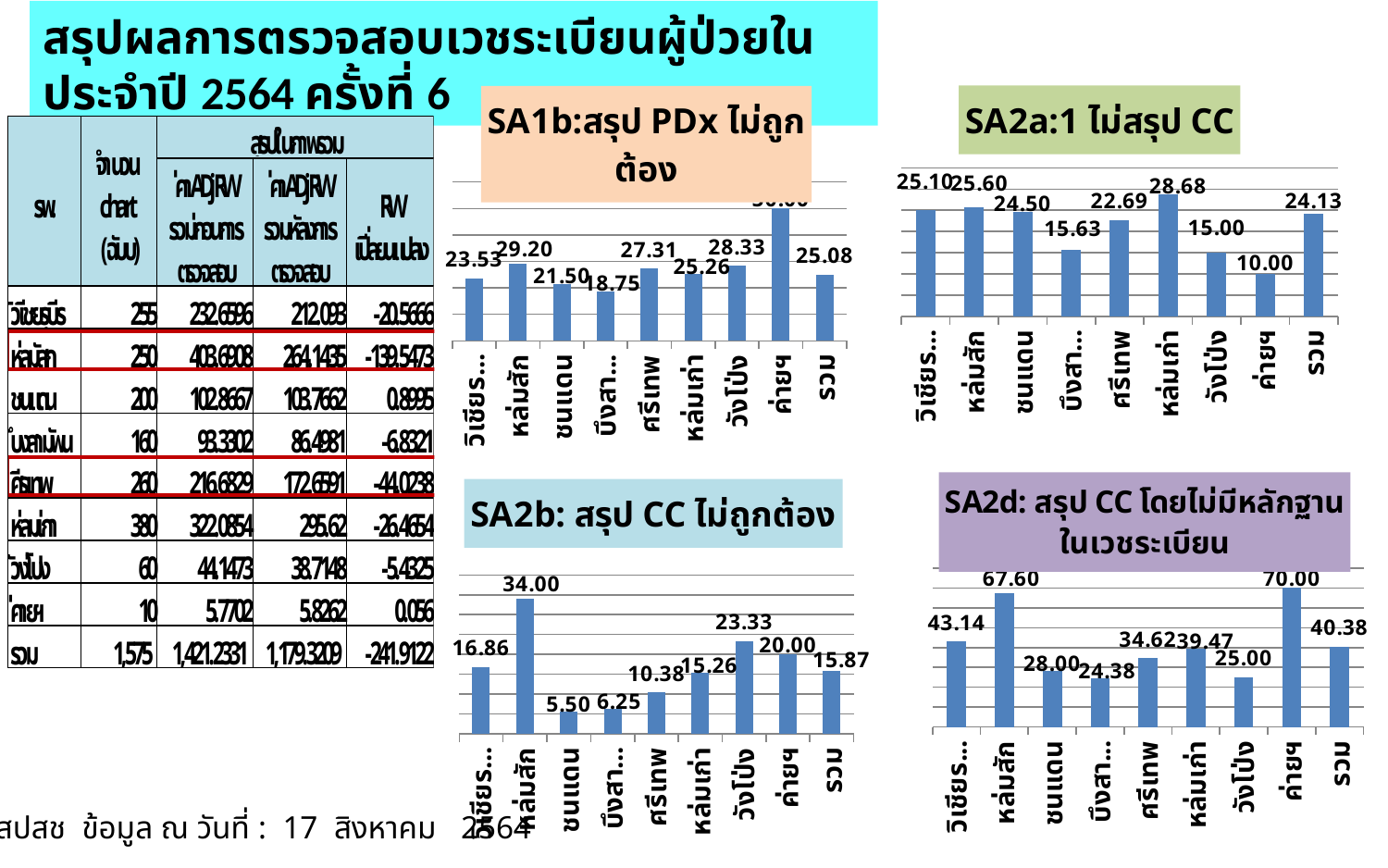
In the chart titled "SA1b:สรุป PDx ไม่ถูกต้อง", what is the difference between the values for วังโป่ง and ศรีเทพ? 1.02 In the chart titled "SA2a:1 ไม่สรุป CC", which category has the lowest value? ค่ายฯ In the chart titled "SA1b:สรุป PDx ไม่ถูกต้อง", what is the value for วังโป่ง? 28.33 In the chart titled "SA2d: สรุป CC โดยไม่มีหลักฐานในเวชระเบียน", what is the value for ค่ายฯ? 70.00 In the chart titled "SA2b: สรุป CC ไม่ถูกต้อง", which is larger, the value for วังโป่ง or the value for ค่ายฯ? วังโป่ง How many categories are shown in the chart titled "SA2d: สรุป CC โดยไม่มีหลักฐานในเวชระเบียน"? 9 What kind of chart is the chart titled "SA2a:1 ไม่สรุป CC"? bar chart In the chart titled "SA2a:1 ไม่สรุป CC", what is the value for หล่มเก่า? 28.68 In the chart titled "SA2b: สรุป CC ไม่ถูกต้อง", which category has the highest value? หล่มสัก In the chart titled "SA2d: สรุป CC โดยไม่มีหลักฐานในเวชระเบียน", which category has the highest value? ค่ายฯ In the chart titled "SA2b: สรุป CC ไม่ถูกต้อง", which category has the lowest value? ชนแดน In the chart titled "SA2b: สรุป CC ไม่ถูกต้อง", what is the value for หล่มสัก? 34.00